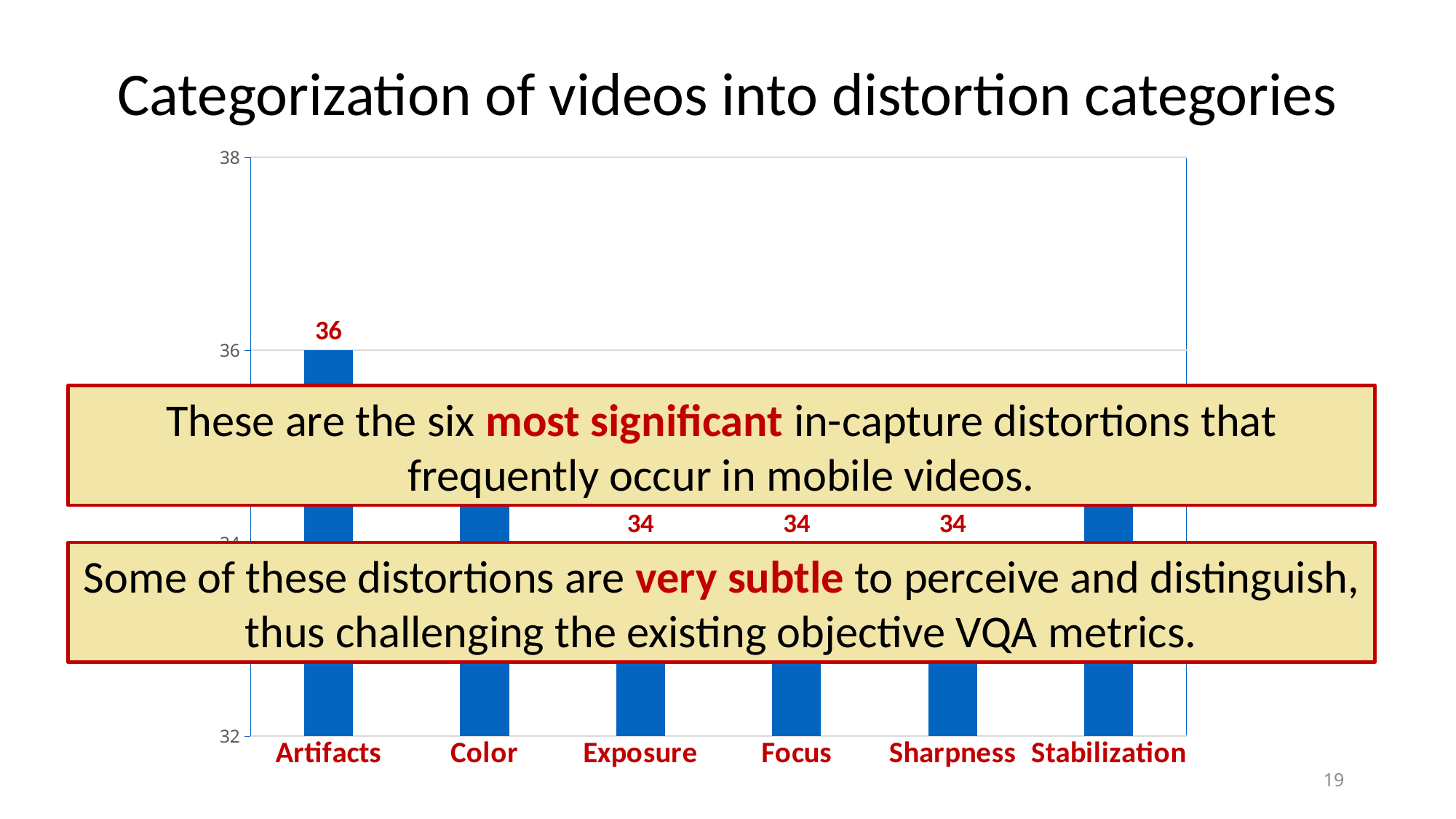
What is the lowest value shown on the y axis of the chart? 32 What is the difference between the values for Artifacts and Focus? 2 What is the value for Exposure? 34 How many distortion categories are shown on the x axis of the chart? 6 What is the value for Artifacts? 36 What is the value for Sharpness? 34 What kind of chart is shown on the slide? bar chart Is the value for Color greater or less than 34? greater Is the value for Stabilization greater or less than 36? less What is the value for Focus? 34 Which category has the highest value? Artifacts Which is larger, the value for Artifacts or the value for Sharpness? Artifacts